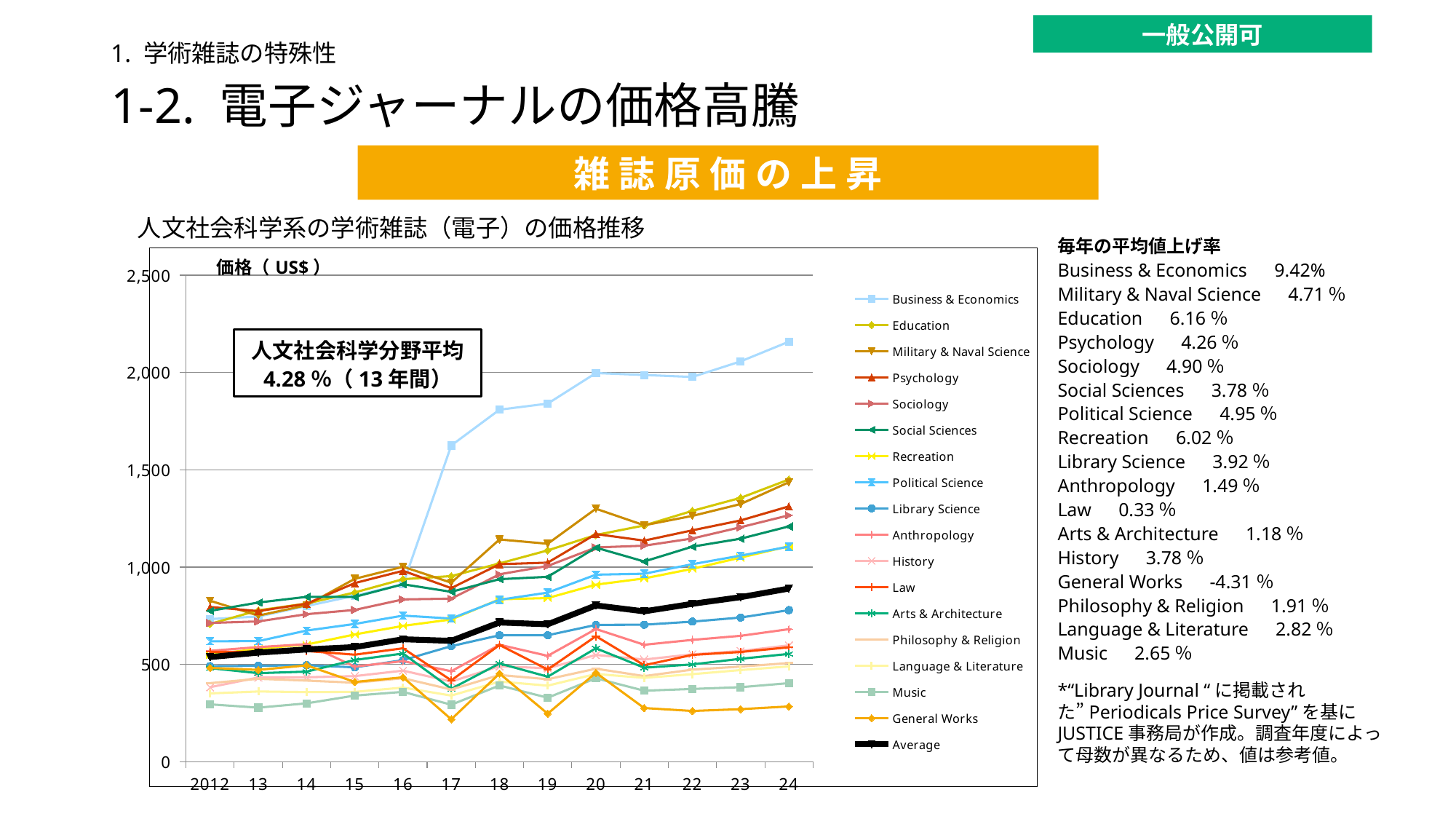
Which series has the lowest value in 2024? General Works Is the value for Business & Economics in 2012 greater or less than 1,000? less What is the label shown on the y axis of the chart? 価格（US$） Is the value for Business & Economics in 2024 greater or less than 2,000? greater Is the value for General Works in 2024 greater or less than 500? less What kind of chart is shown on the slide? line chart Which series has the highest value in 2024? Business & Economics Does the Business & Economics series rise or fall from 2012 to 2024? rise How many years are plotted along the x axis of the chart? 13 How many series does the chart's legend list? 18 Which is larger in 2024, Business & Economics or Average? Business & Economics